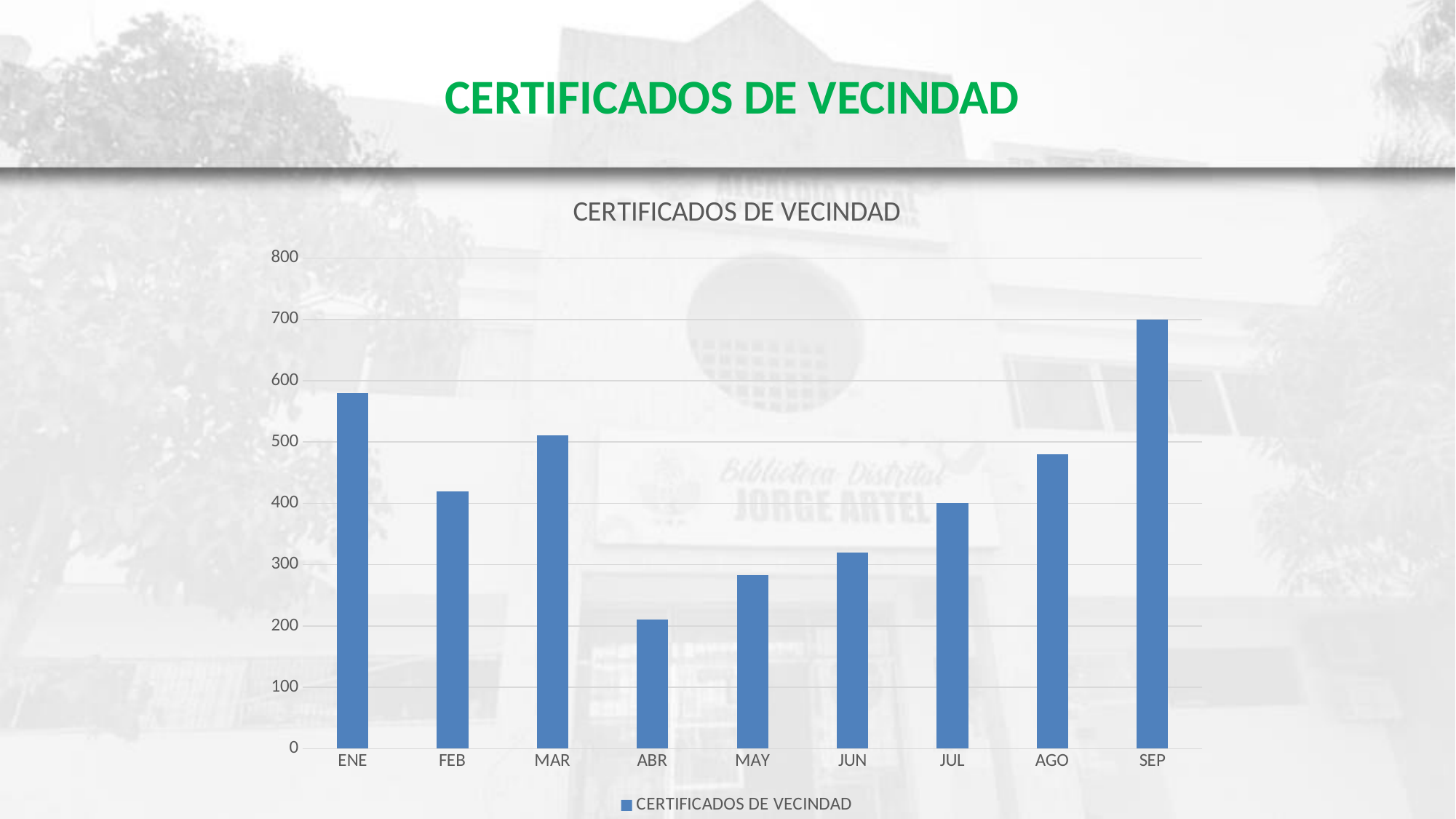
Which month has the highest value in the chart? SEP What is the title of the chart? CERTIFICADOS DE VECINDAD How many months are shown on the x axis of the chart? 9 Which month has the lowest value in the chart? ABR Do the values rise or fall from ABR to SEP? rise Is the value for SEP greater or less than 600? greater What kind of chart is shown on the slide? bar chart Is the value for ENE greater or less than 500? greater Is the value for ABR greater or less than 300? less Which is larger, the value for ENE or the value for FEB? ENE How many series does the legend list? 1 Which is larger, the value for MAY or the value for AGO? AGO